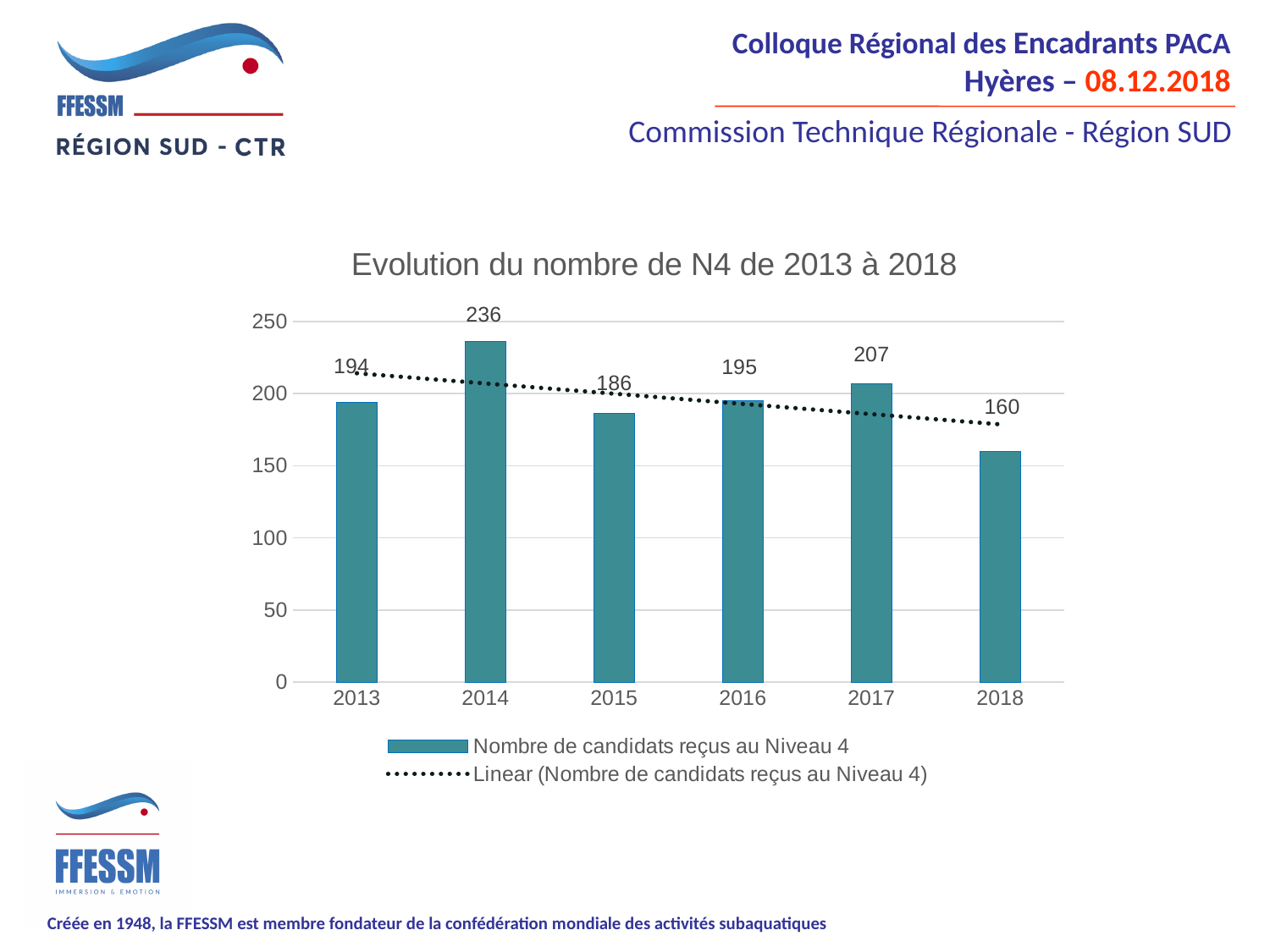
How many entries does the legend list? 2 Which year has the lowest number of candidates received at Niveau 4? 2018 What is the value for 2018? 160 What is the value for 2014? 236 Which year has the highest number of candidates received at Niveau 4? 2014 What is the difference between the values for 2014 and 2018? 76 Is the value for 2015 greater or less than 200? less What is the title of the chart? Evolution du nombre de N4 de 2013 à 2018 Which is larger, the value for 2013 or the value for 2017? 2017 How many years are shown on the x axis? 6 What kind of chart is shown? bar chart What is the value for 2016? 195